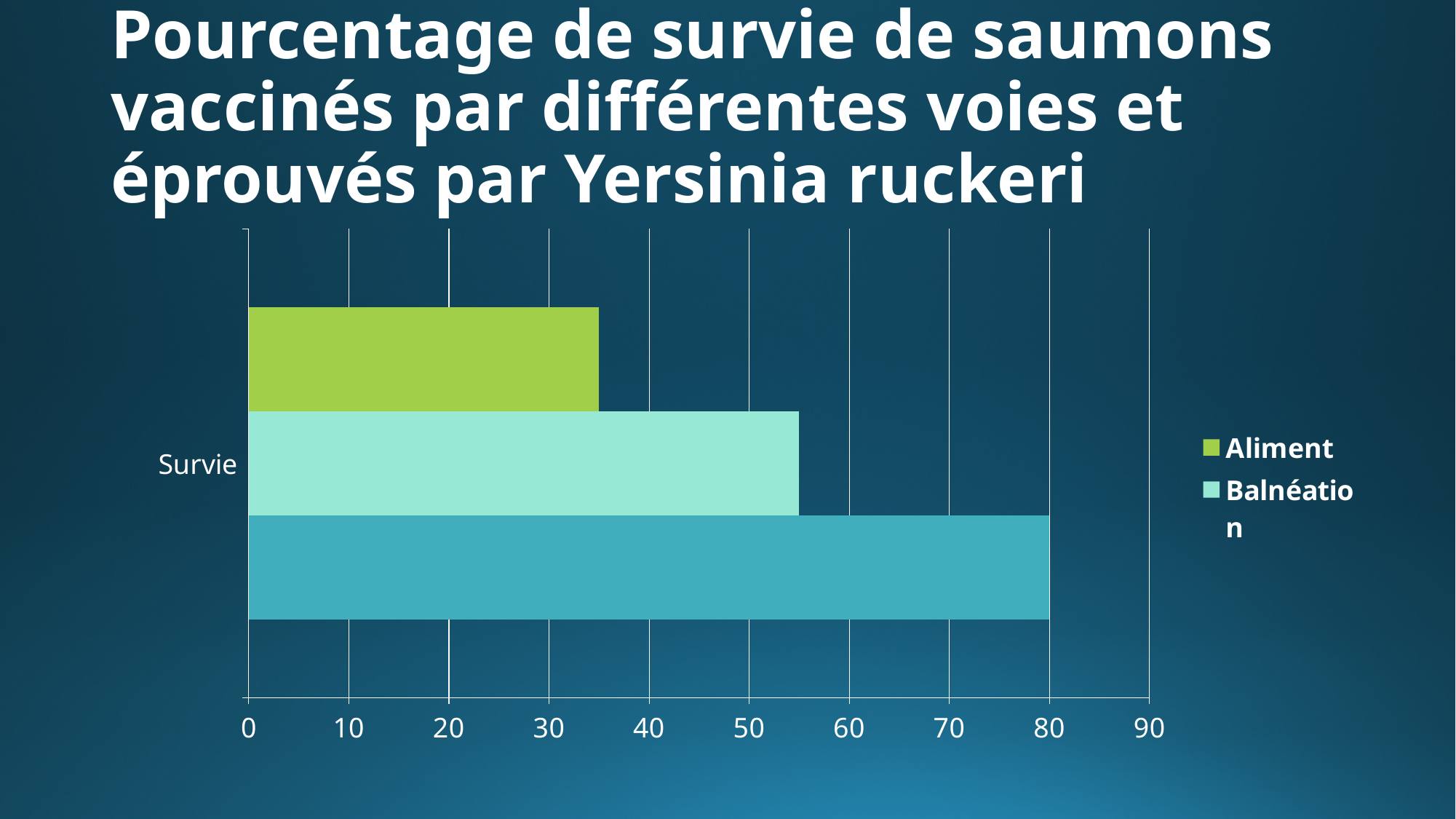
Is the value for Aliment greater or less than 30? greater What kind of chart is shown on the slide? bar chart Which is larger, the value for Aliment or the value for Balnéation? Balnéation Is the value for Aliment greater or less than 40? less Is the value for Balnéation greater or less than 50? greater Which legend entry is shown in green? Aliment How many series does the legend list? 2 How many categories are shown on the vertical axis? 1 What value does the longest bar in the chart reach on the horizontal axis? 80 What is the highest value shown on the horizontal axis? 90 What is the name of the single category on the vertical axis? Survie